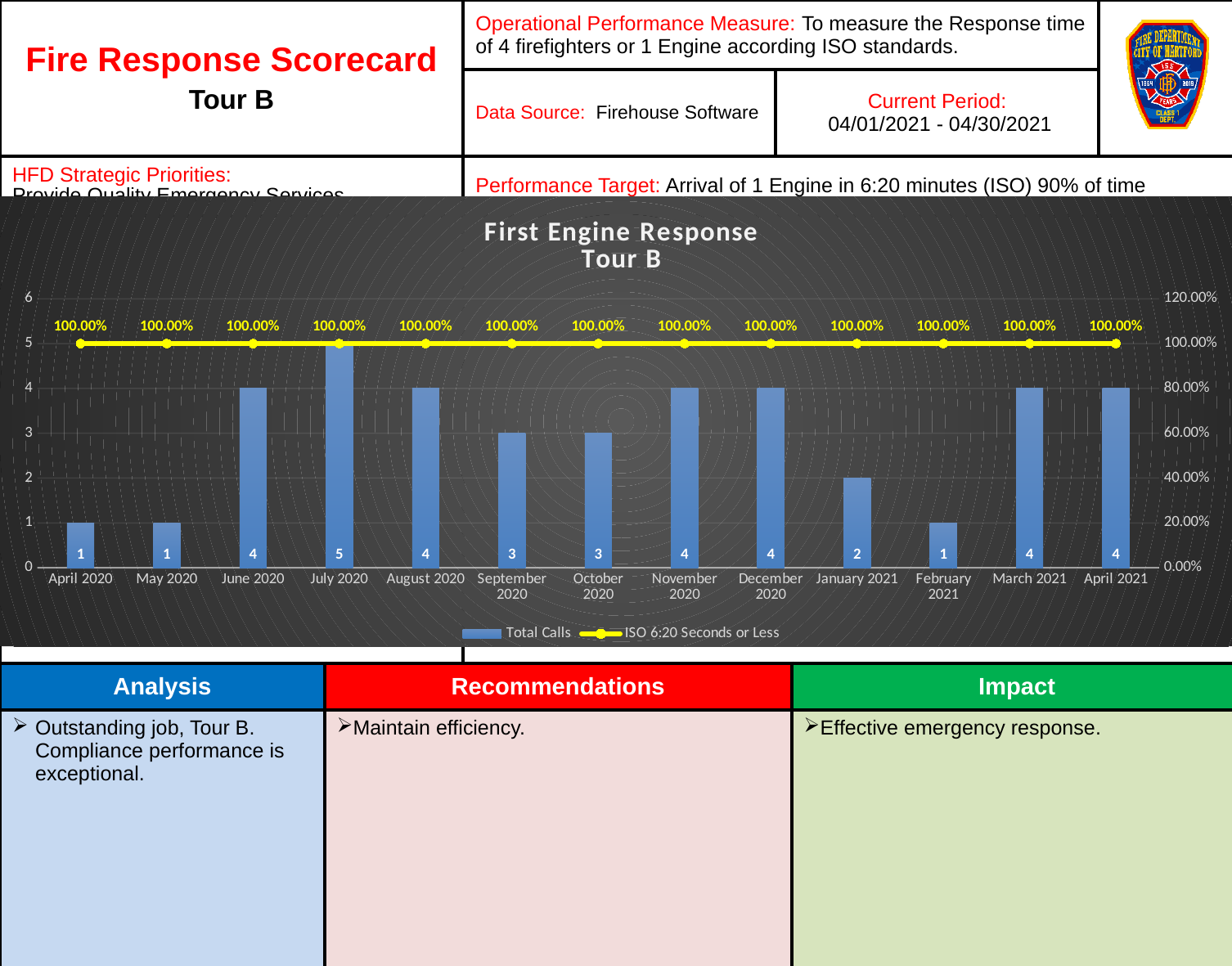
Does the ISO 6:20 Seconds or Less line rise, fall, or stay flat across the months? Stays flat What kind of chart is used for the Total Calls series? Bar chart How many series does the legend list? 2 What is the ISO 6:20 Seconds or Less value for April 2021? 100.00% Which month has the highest Total Calls value? July 2020 How many months are shown on the x axis? 13 Which has more Total Calls, June 2020 or September 2020? June 2020 What colour is the ISO 6:20 Seconds or Less line? Yellow What is the Total Calls value for July 2020? 5 What is the difference in Total Calls between July 2020 and February 2021? 4 What is the Total Calls value for January 2021? 2 What is the title of the chart? First Engine Response Tour B